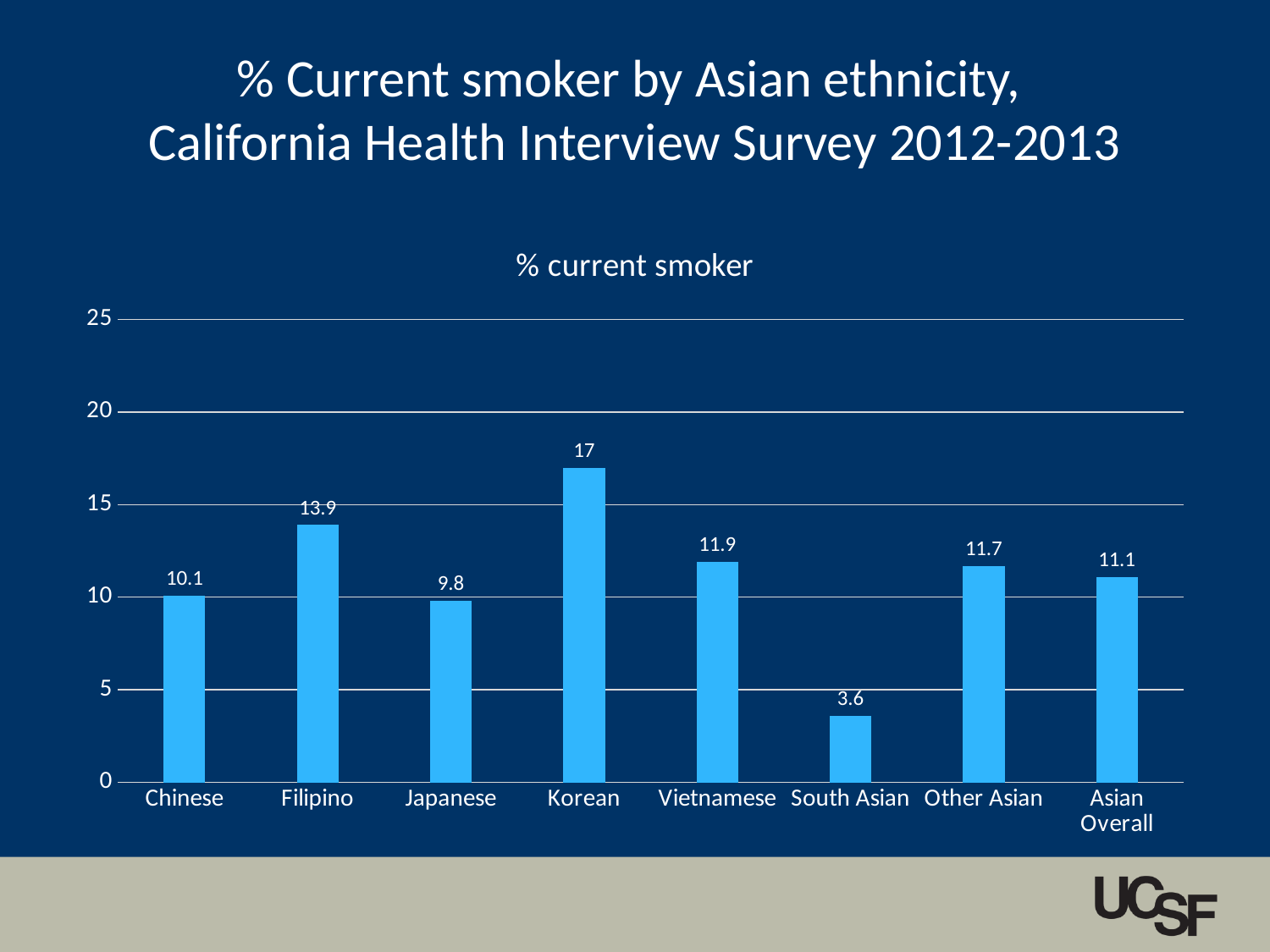
How many ethnicity categories are shown on the x axis? 8 What is the % current smoker value for Asian Overall? 11.1 What kind of chart is shown on the slide? bar chart What is the title shown above the chart's plot area? % current smoker What is the difference between the Korean and Chinese % current smoker values? 6.9 What is the % current smoker value for Korean? 17 What is the % current smoker value for South Asian? 3.6 Which ethnicity has the highest % current smoker? Korean Is the value for Filipino greater or less than 15? less Which has a higher % current smoker, Vietnamese or Other Asian? Vietnamese What is the difference between the Filipino and Japanese % current smoker values? 4.1 Which ethnicity has the lowest % current smoker? South Asian